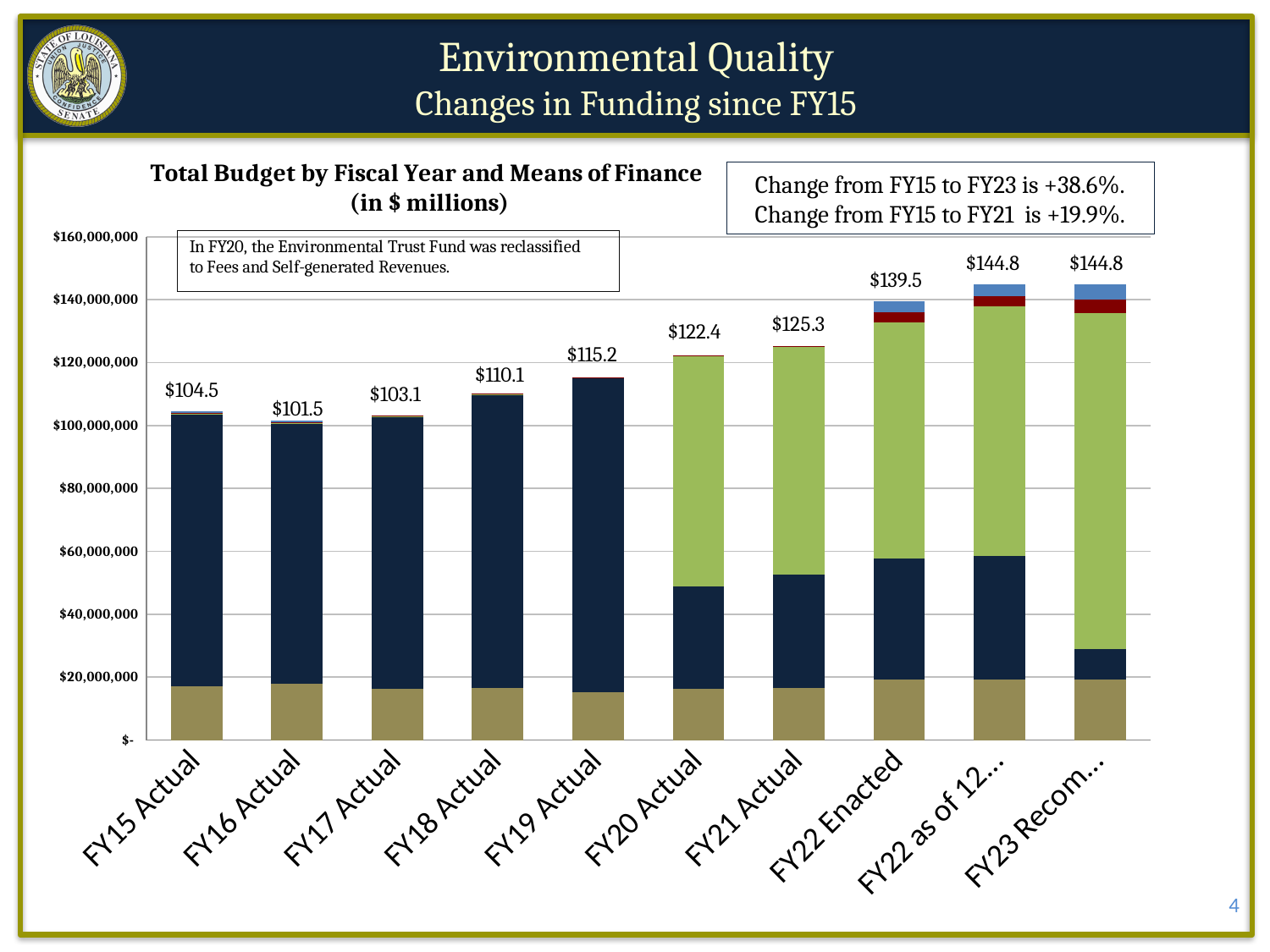
What is the difference between the labeled totals for FY19 Actual and FY15 Actual? $10.7 How many fiscal year bars are shown in the chart? 10 Which has a larger total budget, FY18 Actual or FY17 Actual? FY18 Actual What is the title of the chart? Total Budget by Fiscal Year and Means of Finance (in $ millions) What kind of chart is shown on the slide? Stacked bar chart What is the difference between the labeled totals for FY21 Actual and FY20 Actual? $2.9 Do the total budgets rise or fall from FY16 Actual through FY22 Enacted? Rise What is the total budget labeled for FY22 Enacted? $139.5 What is the total budget labeled for FY15 Actual? $104.5 Which fiscal year has the lowest total budget? FY16 Actual Is the total for FY21 Actual greater or less than $120,000,000? greater What is the total budget labeled for FY19 Actual? $115.2